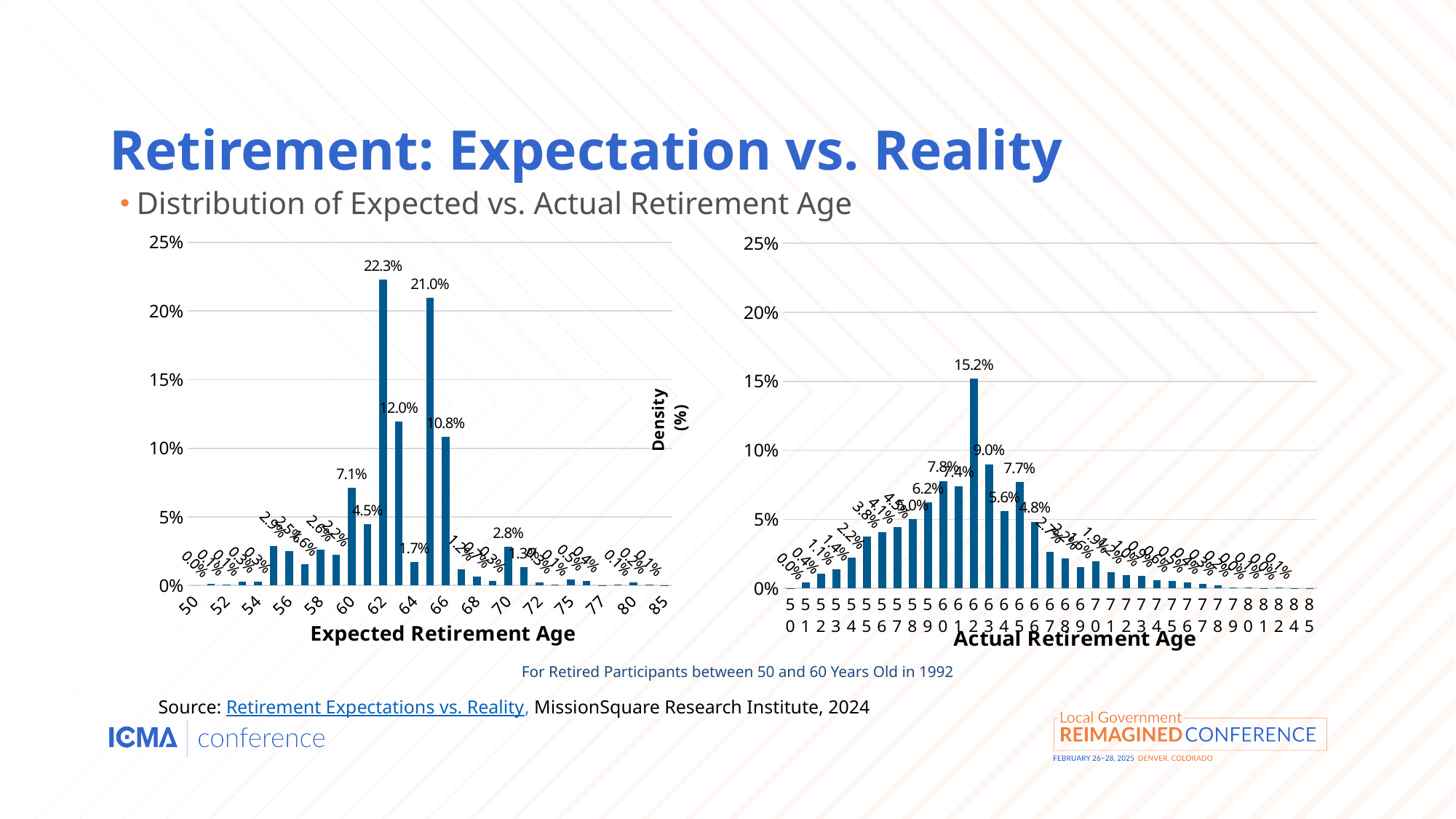
In the Actual Retirement Age chart, is the value for age 62 greater or less than 10%? greater In the Actual Retirement Age chart, what is the value for age 62? 15.2% Which is larger: the peak value in the Expected Retirement Age chart (age 62) or the peak value in the Actual Retirement Age chart (age 62)? Expected Retirement Age (22.3%) In the Expected Retirement Age chart, what is the value for age 65? 21.0% What is the difference between the peak value of the Expected Retirement Age chart (22.3%) and the peak value of the Actual Retirement Age chart (15.2%)? 7.1% In the Actual Retirement Age chart, which age has the highest value? 62 What kind of chart is the Expected Retirement Age chart on the left? bar chart In the Expected Retirement Age chart, what is the value for age 62? 22.3% In the Actual Retirement Age chart, what is the value for age 63? 9.0% What is the label of the vertical axis shown between the two charts? Density (%) In the Expected Retirement Age chart, which age has the highest value? 62 In the Expected Retirement Age chart, what is the difference between the values for age 62 and age 65? 1.3%